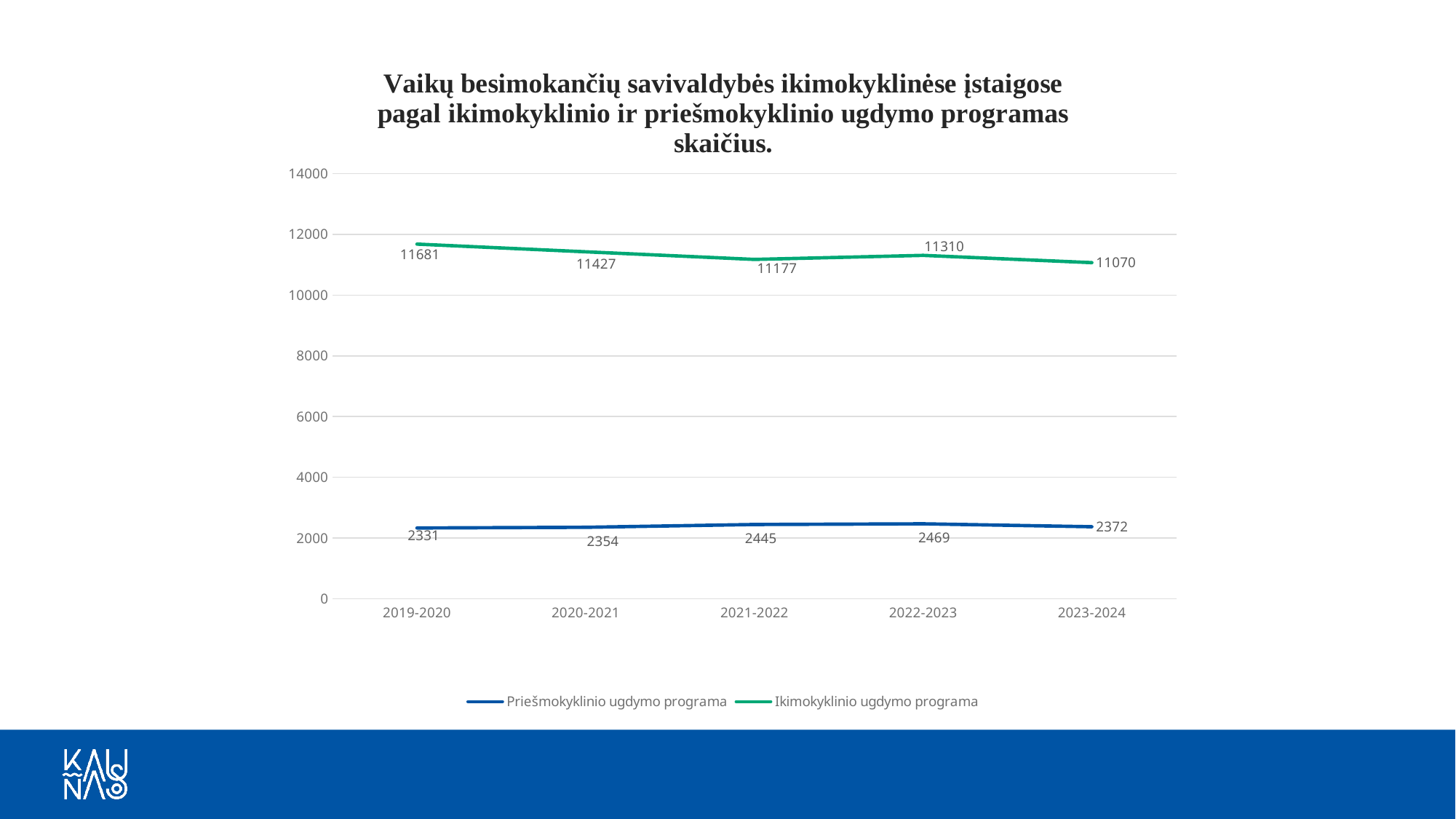
What is the difference between the Ikimokyklinio ugdymo programa values in 2019-2020 and 2023-2024? 611 How many series does the legend list? 2 Which is larger: the Ikimokyklinio ugdymo programa value in 2020-2021 or in 2022-2023? 2020-2021 What kind of chart is shown on the slide? line chart Is the value for Ikimokyklinio ugdymo programa in 2021-2022 greater or less than 12000? less What is the value for Priešmokyklinio ugdymo programa in 2021-2022? 2445 What is the value for Ikimokyklinio ugdymo programa in 2019-2020? 11681 In which school year is the Priešmokyklinio ugdymo programa value highest? 2022-2023 How many school years are shown on the x axis? 5 In which school year is the Ikimokyklinio ugdymo programa value lowest? 2023-2024 What is the difference between the Priešmokyklinio ugdymo programa values in 2022-2023 and 2019-2020? 138 What is the value for Ikimokyklinio ugdymo programa in 2023-2024? 11070